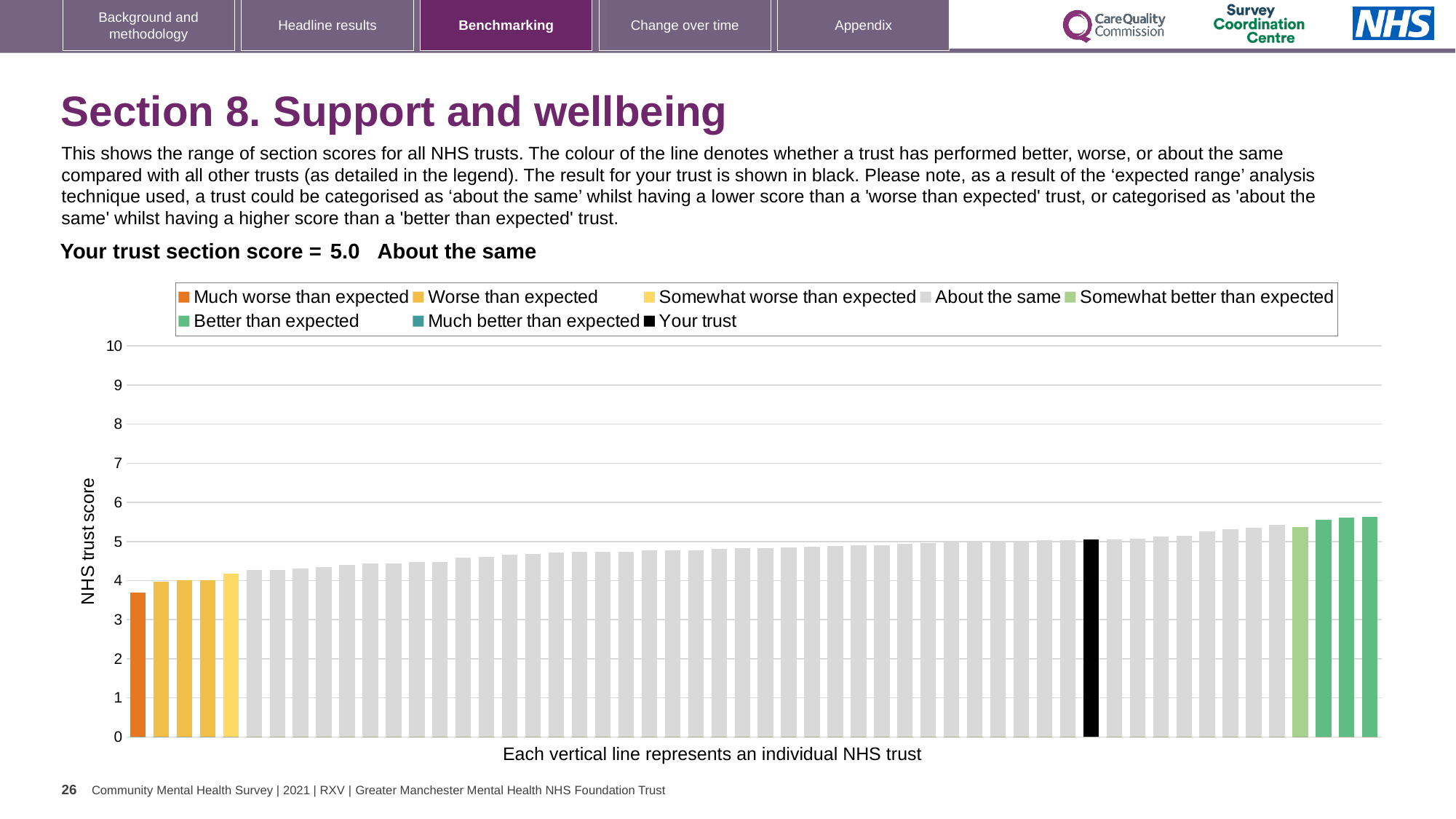
Which legend category does the lowest-scoring trust belong to? Much worse than expected Is the value of the tallest bar greater or less than 6? less What is the label on the y axis of the chart? NHS trust score How many entries does the chart legend list? 8 What is the section score for your trust shown on the slide? 5.0 Is the value of the leftmost (orange) bar greater or less than 4? less What kind of chart is shown on the slide? bar chart Do the bar values rise or fall from left to right along the x axis? rise Is the value of the black 'Your trust' bar greater or less than 4? greater What colour is used for the 'Your trust' bar? black How many bars are coloured as 'Better than expected'? 3 How many bars are coloured as 'Much worse than expected'? 1